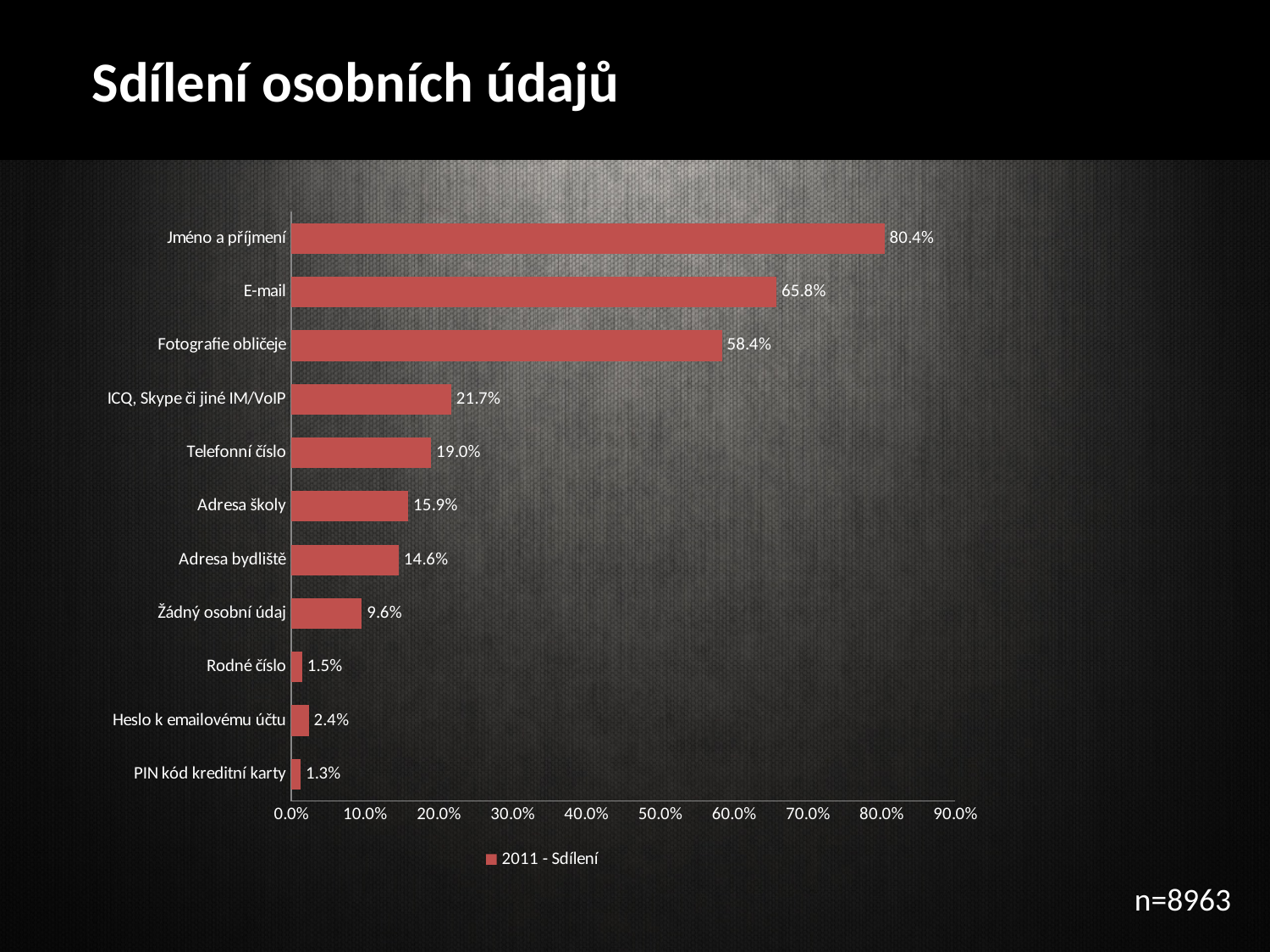
How many categories are shown in the chart? 11 What kind of chart is shown on the slide? bar chart What is the value for Telefonní číslo? 19.0% Which category has the highest value? Jméno a příjmení Which is larger, the value for Adresa školy or the value for Adresa bydliště? Adresa školy Is the value for Fotografie obličeje greater or less than 50.0%? greater What is the difference between the values for Jméno a příjmení and E-mail? 14.6% Which category has the lowest value? PIN kód kreditní karty What is the value for E-mail? 65.8% How many series does the legend list? 1 What is the legend entry for the series shown? 2011 - Sdílení What is the value for Žádný osobní údaj? 9.6%